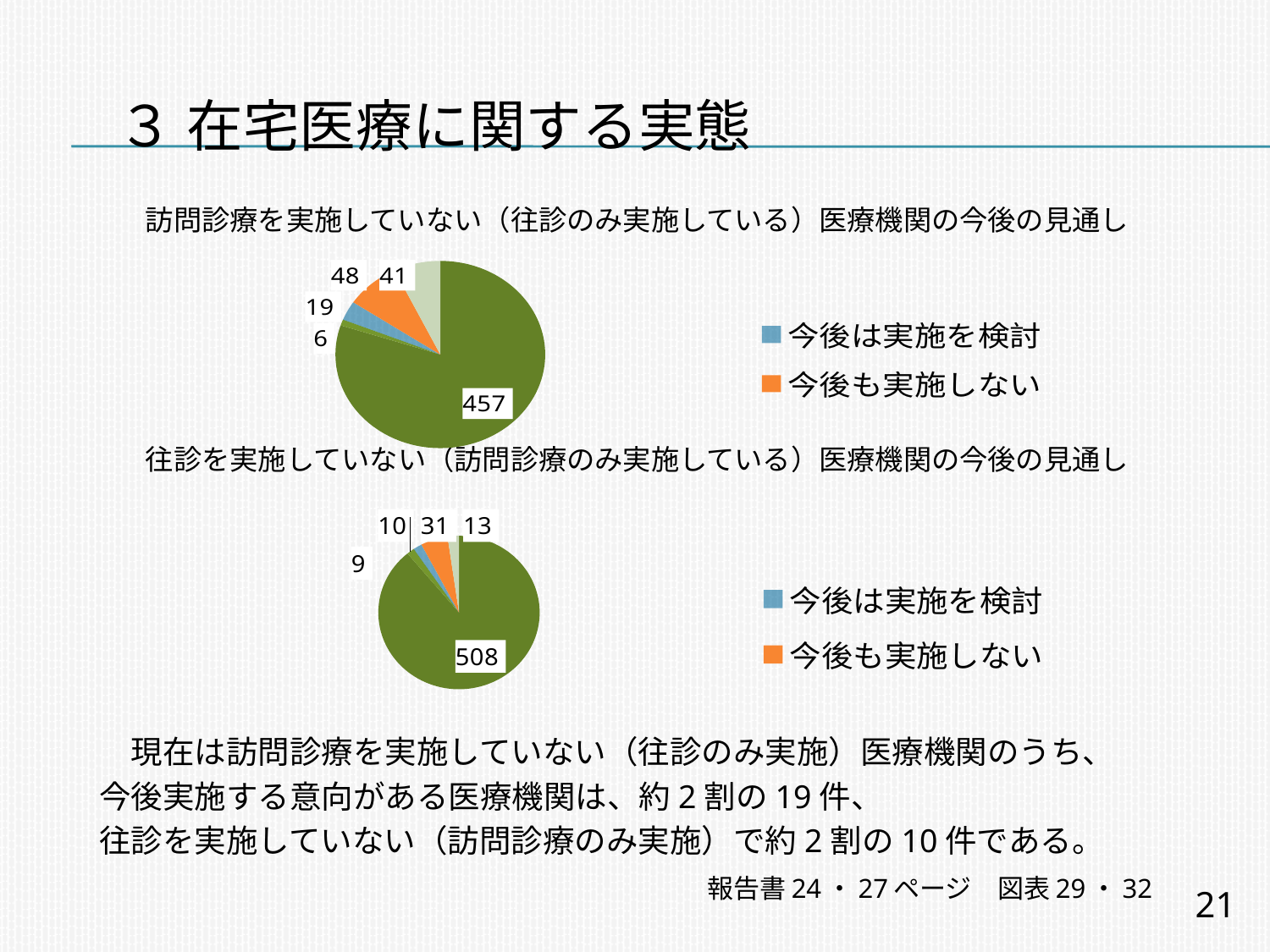
In the top pie chart, what is the value of the largest slice? 457 In the top pie chart (訪問診療を実施していない医療機関の今後の見通し), what is the value for 今後は実施を検討? 19 In the top pie chart, what is the difference between 今後も実施しない and 今後は実施を検討? 29 In the bottom pie chart (往診を実施していない医療機関の今後の見通し), what is the value for 今後は実施を検討? 10 What kind of chart is used for 往診を実施していない医療機関の今後の見通し? Pie chart In the bottom pie chart, what is the value of the largest slice? 508 In the bottom pie chart (往診を実施していない医療機関の今後の見通し), what is the value for 今後も実施しない? 31 How many slices does the top pie chart have? 5 In the top pie chart, what colour is the 今後も実施しない slice? Orange In the bottom pie chart, which is larger, 今後は実施を検討 or 今後も実施しない? 今後も実施しない In the top pie chart (訪問診療を実施していない医療機関の今後の見通し), what is the value for 今後も実施しない? 48 How many entries does the legend of the bottom pie chart list? 2